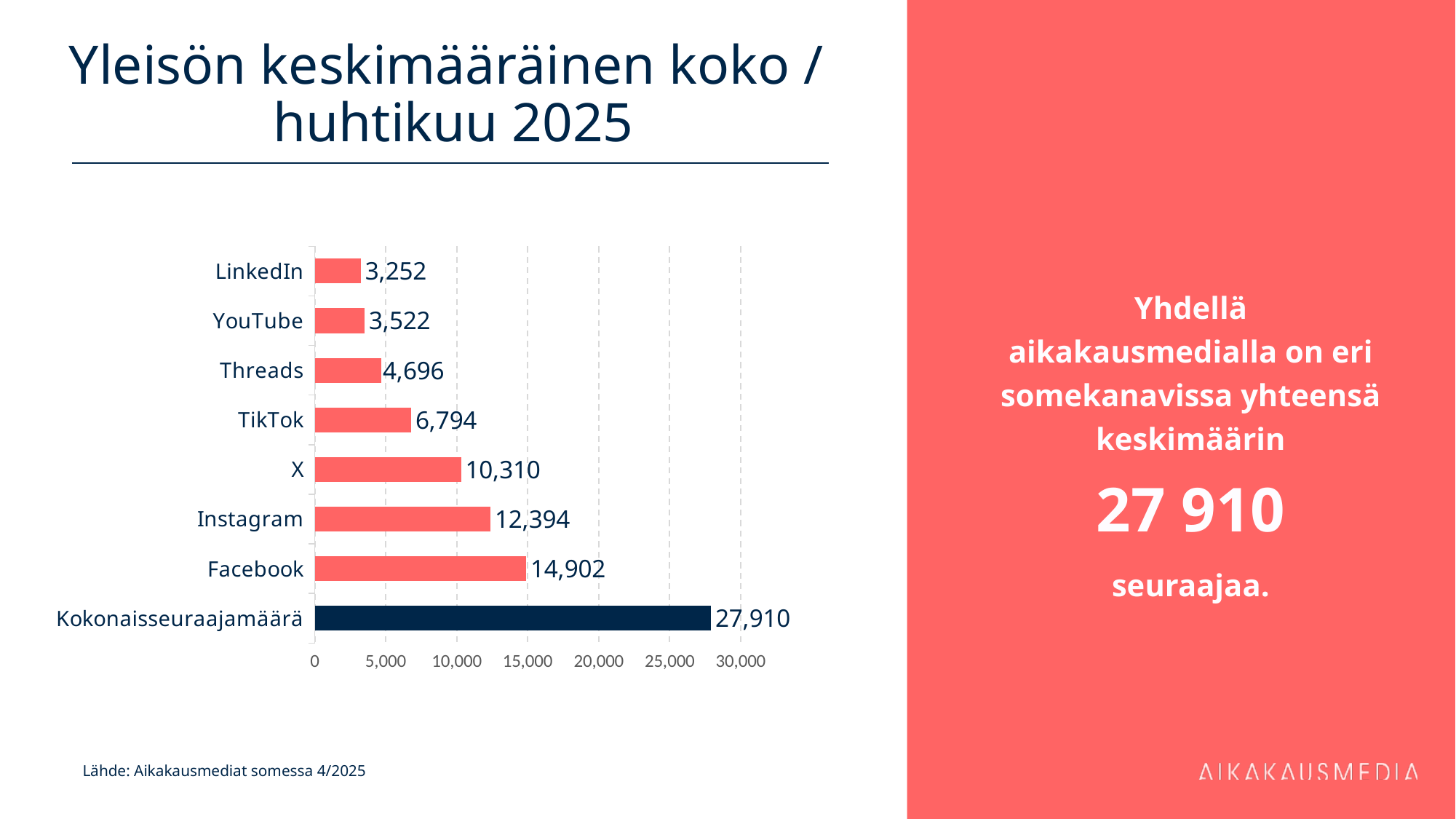
What kind of chart is shown on the slide? bar chart What is the difference between the values for Instagram and X? 2,084 Which is larger, the value for YouTube or the value for Threads? Threads What is the value for Facebook? 14,902 What is the value for TikTok? 6,794 Which bar is shown in a different colour (dark navy) from the others? Kokonaisseuraajamäärä Is the value for X greater or less than 10,000? greater Which individual platform (excluding Kokonaisseuraajamäärä) has the highest value? Facebook How many categories are shown on the chart? 8 What is the value for Kokonaisseuraajamäärä? 27,910 Which category has the lowest value? LinkedIn What is the difference between the values for Facebook and LinkedIn? 11,650